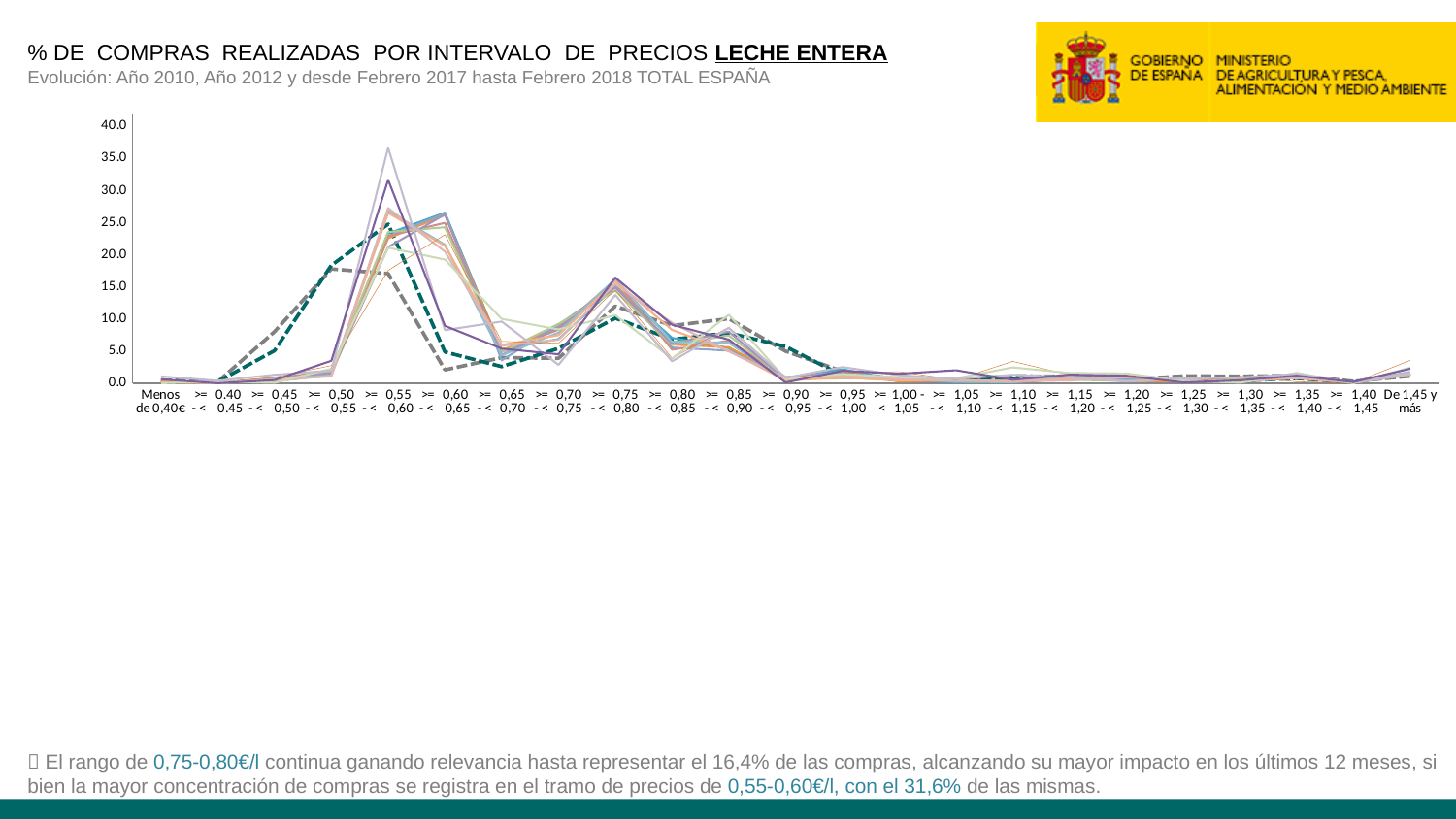
What is the highest tick value shown on the y axis of the chart? 40.0 Are the values plotted for the '>= 1,00 -< 1,05' interval greater or less than 5.0? less Is the highest value plotted on the chart greater or less than 40.0? less Is the highest line at the '>= 0,75 -< 0,80' interval greater or less than 10.0? greater In which price interval does the chart reach its highest plotted value? >= 0,55 -< 0,60 Do the plotted values rise or fall from the '>= 0,75 -< 0,80' interval to the '>= 0,95 -< 1,00' interval? fall What is the title of the chart on the slide? % DE COMPRAS REALIZADAS POR INTERVALO DE PRECIOS LECHE ENTERA How many price intervals are shown along the x axis of the chart? 23 What kind of chart is shown on the slide? line chart